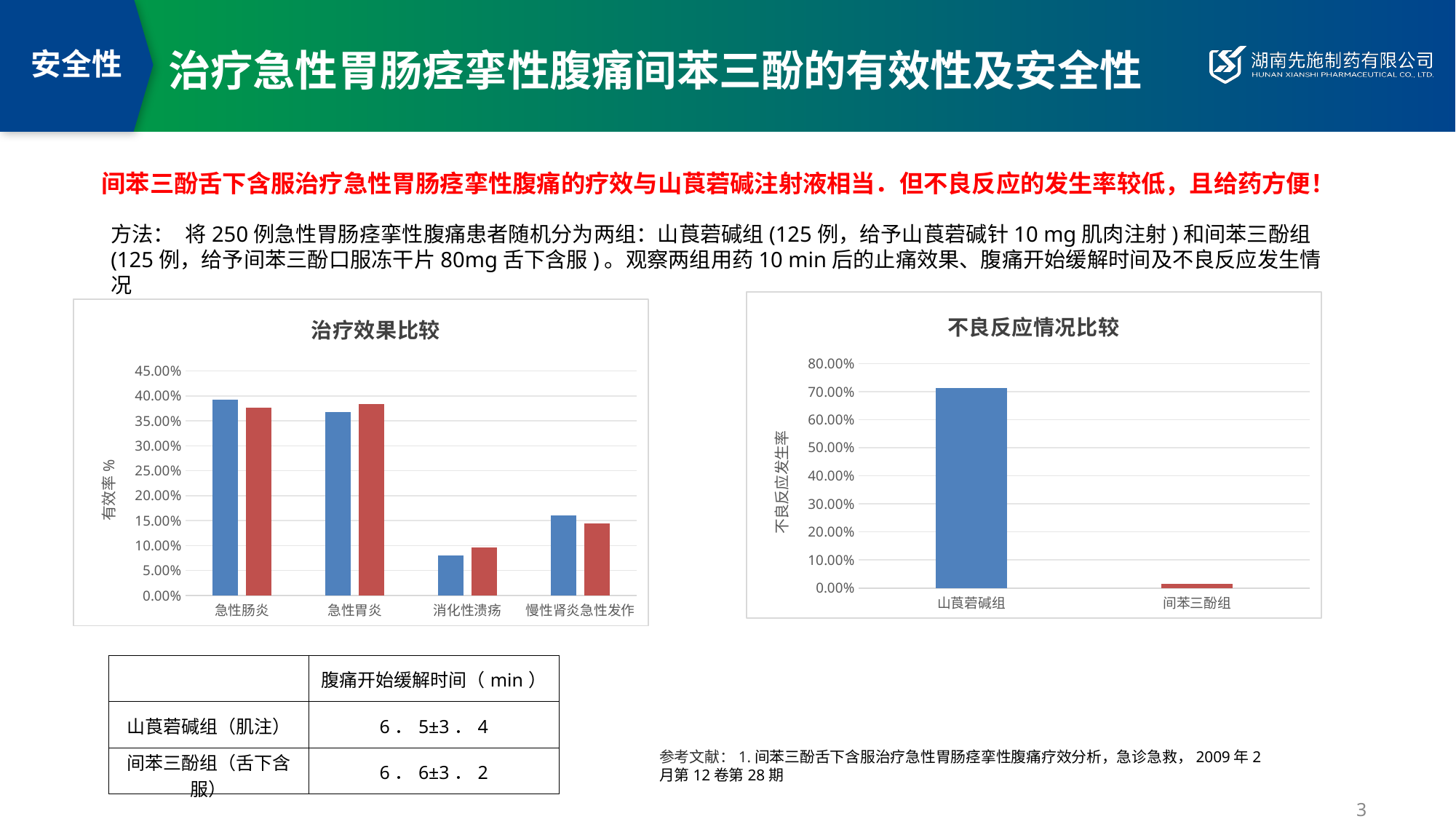
In the "不良反应情况比较" chart, which group has the lowest adverse reaction rate? 间苯三酚组 In the "不良反应情况比较" chart, is the value for 山莨菪碱组 greater or less than 60.00%? greater In the "治疗效果比较" chart, is the red bar for 慢性肾炎急性发作 greater or less than 20.00%? less In the "治疗效果比较" chart, is the blue bar for 急性肠炎 greater or less than 35.00%? greater How many categories are shown on the x axis of the "治疗效果比较" chart? 4 In the "不良反应情况比较" chart, which group has the highest adverse reaction rate? 山莨菪碱组 What kind of chart is the "不良反应情况比较" chart? bar chart What kind of chart is the "治疗效果比较" chart? bar chart How many categories are shown on the x axis of the "不良反应情况比较" chart? 2 In the "治疗效果比较" chart, which category has the lowest blue bar? 消化性溃疡 What is the y-axis label of the "不良反应情况比较" chart? 不良反应发生率